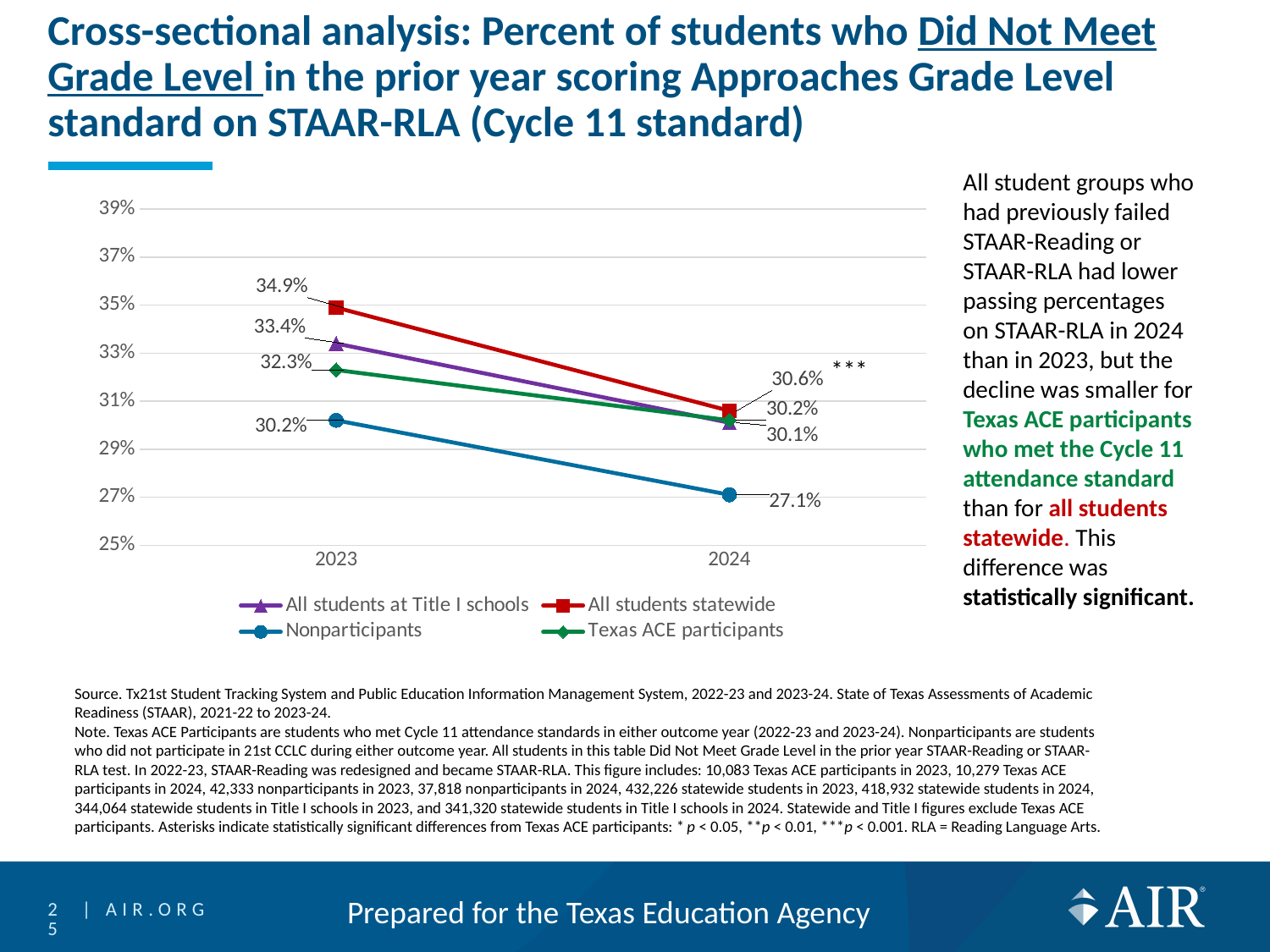
Which series has the highest value in 2023? All students statewide What is the value for All students at Title I schools in 2023? 33.4% In 2023, which is larger: All students at Title I schools or Texas ACE participants? All students at Title I schools What kind of chart is shown on the slide? Line chart Which series has the lowest value in 2024? Nonparticipants How many series does the legend list? 4 By how many percentage points did the value for Nonparticipants change from 2023 (30.2%) to 2024 (27.1%)? 3.1 percentage points What is the value for Texas ACE participants in 2023? 32.3% Does the value for All students statewide rise or fall from 2023 to 2024? Fall What is the value for All students statewide in 2023? 34.9% How many years are shown on the x axis? 2 What is the value for Nonparticipants in 2024? 27.1%